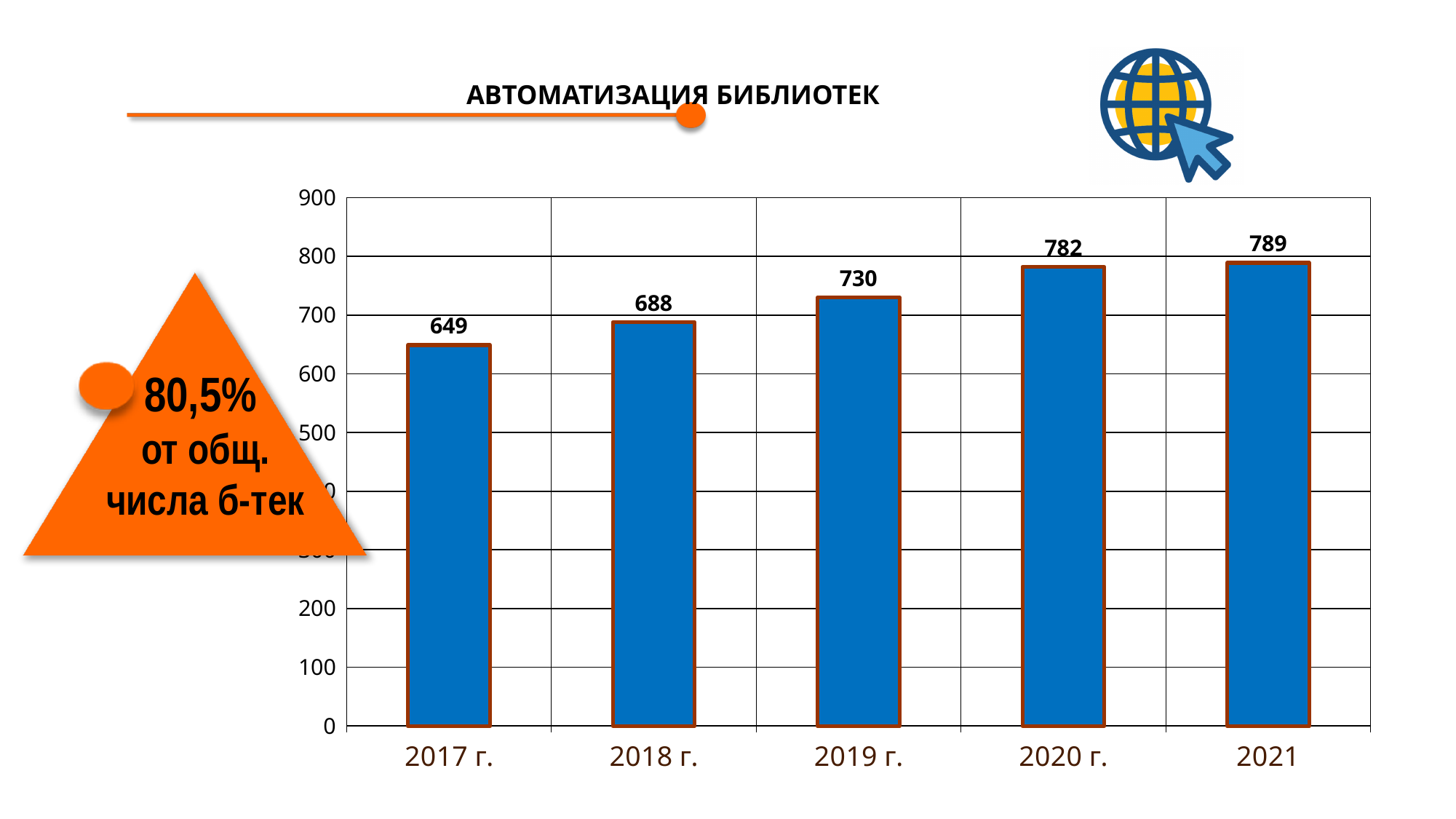
What is the value for 2017 г.? 649 What is the difference between the values for 2020 г. and 2019 г.? 52 What is the value for 2019 г.? 730 Which year has the lowest value? 2017 г. Is the value for 2018 г. greater or less than 700? less What is the value for 2021? 789 What is the difference between the values for 2021 and 2017 г.? 140 Which is larger, the value for 2018 г. or the value for 2019 г.? 2019 г. How many years are shown on the x axis? 5 Do the values rise or fall from 2017 г. to 2021? rise What kind of chart is shown on the slide? bar chart Which year has the highest value? 2021